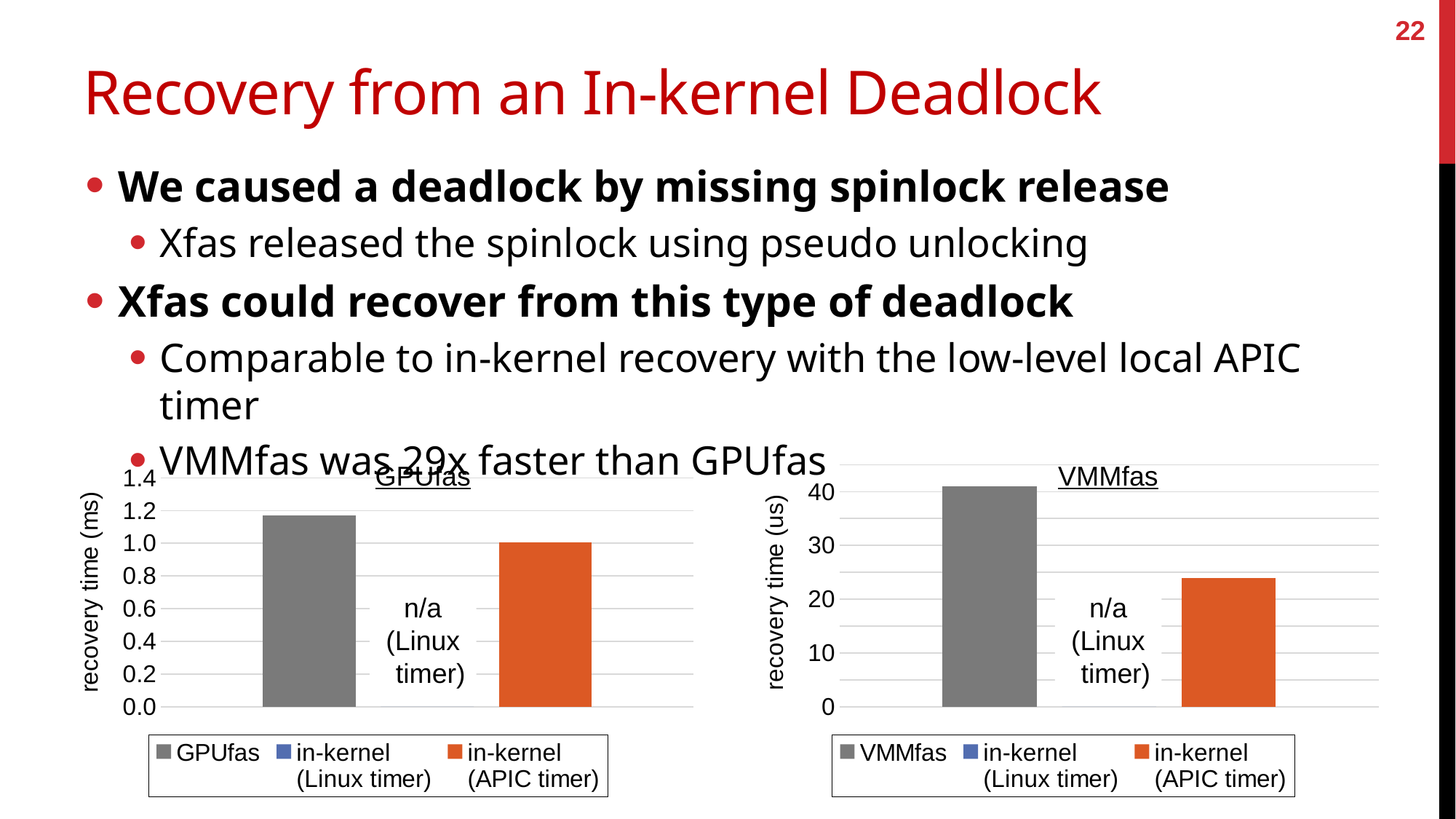
In the GPUfas chart, which is larger, GPUfas or in-kernel (APIC timer)? GPUfas In the GPUfas chart, what is the y-axis label? recovery time (ms) In the VMMfas chart, which is larger, VMMfas or in-kernel (APIC timer)? VMMfas In the VMMfas chart, how many series does the legend list? 3 In the VMMfas chart, is the value for in-kernel (APIC timer) greater or less than 30? less In the GPUfas chart, is the value for GPUfas greater or less than 1.0? greater In the GPUfas chart, how many series does the legend list? 3 In the GPUfas chart, is the value for GPUfas greater or less than 1.2? less In the GPUfas chart, what kind of chart is shown? bar chart In the VMMfas chart, what is shown in place of the in-kernel (Linux timer) bar? n/a (Linux timer)